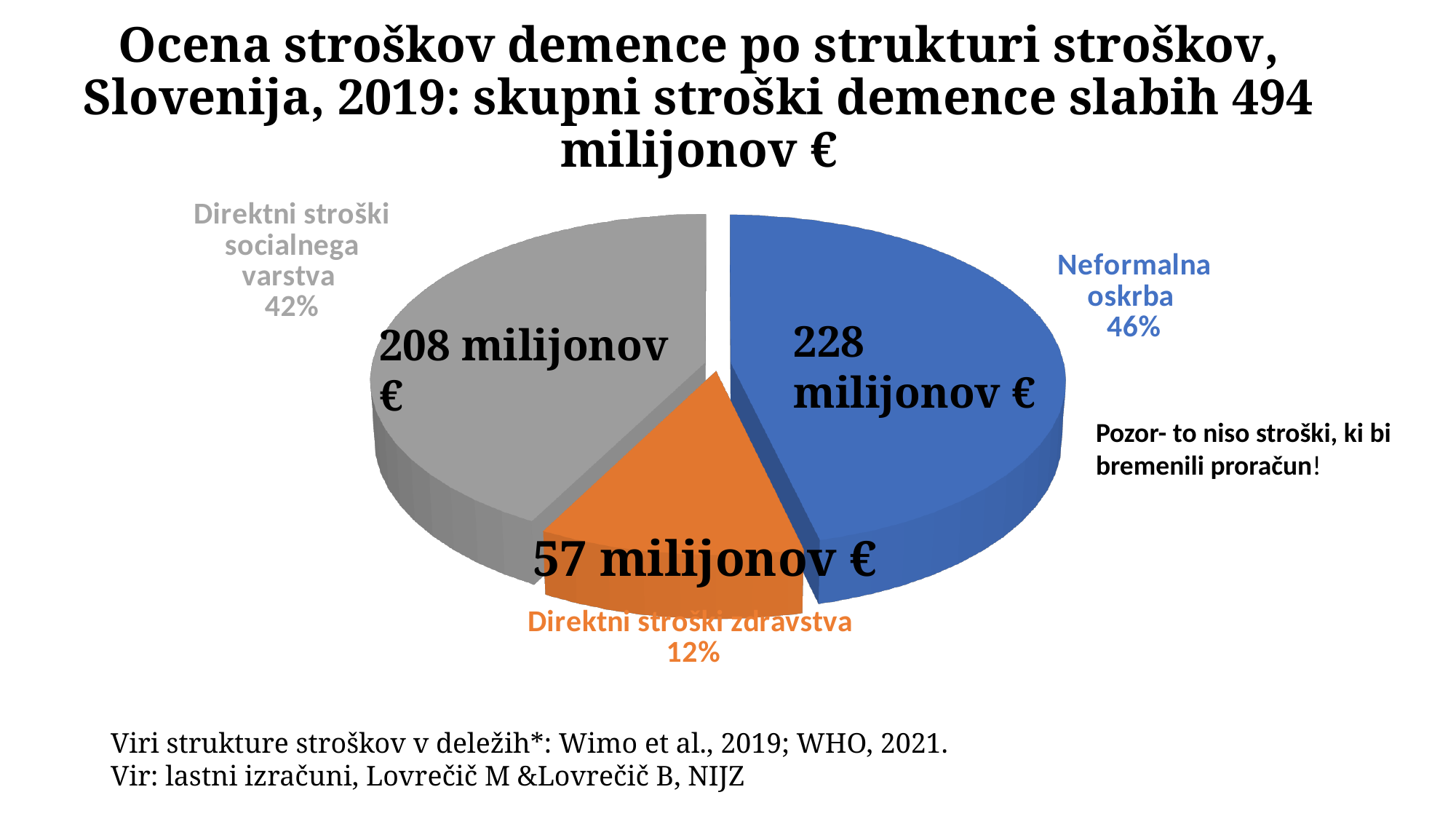
Which colour is used for the Direktni stroški zdravstva slice? orange What share of the pie does Direktni stroški socialnega varstva represent? 42% Which category has the smallest slice of the pie? Direktni stroški zdravstva What is the difference in value between Neformalna oskrba and Direktni stroški zdravstva? 171 milijonov € Which category has the largest slice of the pie? Neformalna oskrba What share of the pie does Direktni stroški zdravstva represent? 12% What is the value shown for Direktni stroški socialnega varstva? 208 milijonov € What is the value shown for Neformalna oskrba? 228 milijonov € What kind of chart is shown on the slide? pie chart What share of the pie does Neformalna oskrba represent? 46% How many slices does the pie chart have? 3 What is the value shown for Direktni stroški zdravstva? 57 milijonov €